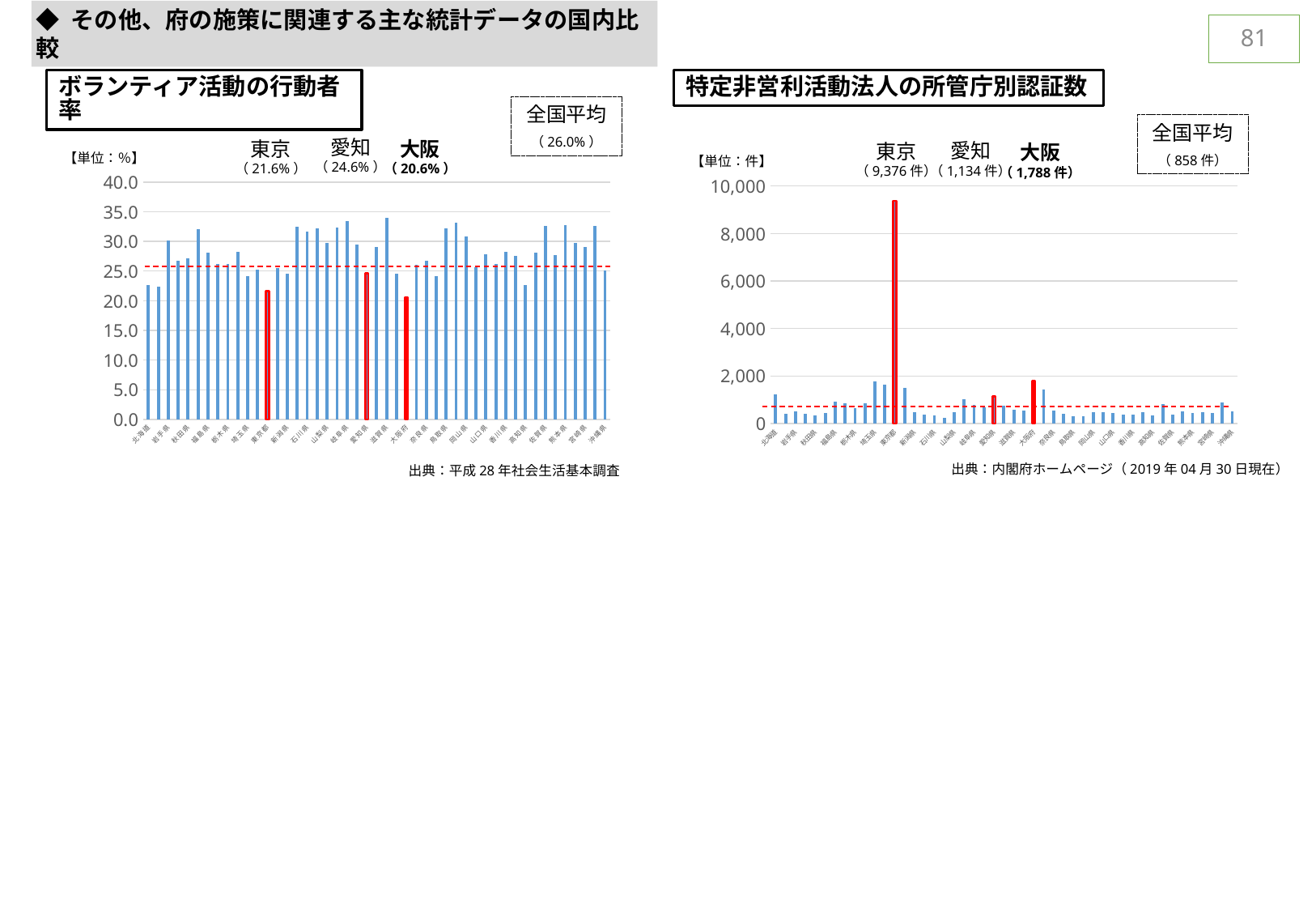
In the ボランティア活動の行動者率 chart on the left, what is the value for 東京? 21.6% In the 特定非営利活動法人の所管庁別認証数 chart on the right, what is the 全国平均 (national average) shown? 858件 In the 特定非営利活動法人の所管庁別認証数 chart on the right, which prefecture has the highest value? 東京 In the 特定非営利活動法人の所管庁別認証数 chart on the right, what is the value for 大阪? 1,788件 In the ボランティア活動の行動者率 chart on the left, is the value for 大阪 greater or less than 25.0? less In the 特定非営利活動法人の所管庁別認証数 chart on the right, what is the value for 東京? 9,376件 In the ボランティア活動の行動者率 chart on the left, which is larger, the value for 愛知 or the value for 大阪? 愛知 What kind of chart is the 特定非営利活動法人の所管庁別認証数 chart on the right? bar chart In the ボランティア活動の行動者率 chart on the left, what is the 全国平均 (national average) shown? 26.0% In the ボランティア活動の行動者率 chart on the left, what is the value for 大阪? 20.6% In the 特定非営利活動法人の所管庁別認証数 chart on the right, what is the difference between the values for 大阪 and 愛知? 654件 In the ボランティア活動の行動者率 chart on the left, what is the difference between the values for 愛知 and 大阪? 4.0%